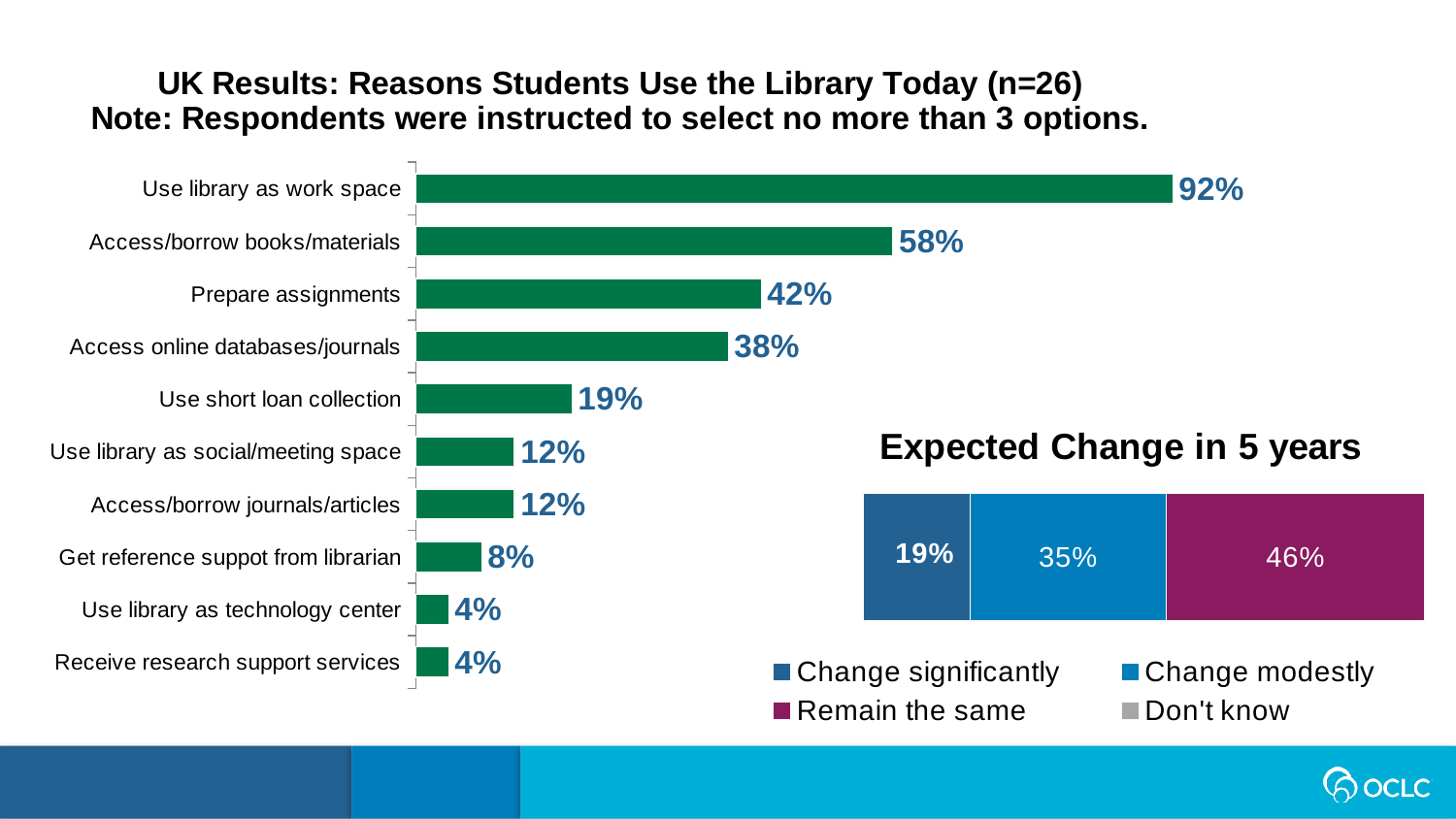
In the 'Reasons Students Use the Library Today' chart, what is the value for 'Access online databases/journals'? 38% In the 'Reasons Students Use the Library Today' chart, what is the difference between 'Access/borrow books/materials' and 'Prepare assignments'? 16% In the 'Reasons Students Use the Library Today' chart, what is the value for 'Use library as social/meeting space'? 12% In the 'Reasons Students Use the Library Today' chart, which reason has the highest percentage? Use library as work space How many series does the legend of the 'Expected Change in 5 years' chart list? 4 What kind of chart is the 'Reasons Students Use the Library Today' chart? Bar chart In the 'Reasons Students Use the Library Today' chart, which is larger: 'Use short loan collection' or 'Get reference suppot from librarian'? Use short loan collection In the 'Expected Change in 5 years' chart, what percentage expect the library to remain the same? 46% In the 'Expected Change in 5 years' chart, what percentage expect the library to change significantly? 19% In the 'Reasons Students Use the Library Today' chart, what percentage of students use the library as work space? 92% How many reasons are listed in the 'Reasons Students Use the Library Today' chart? 10 In the 'Expected Change in 5 years' chart, what is the difference between 'Remain the same' and 'Change modestly'? 11%